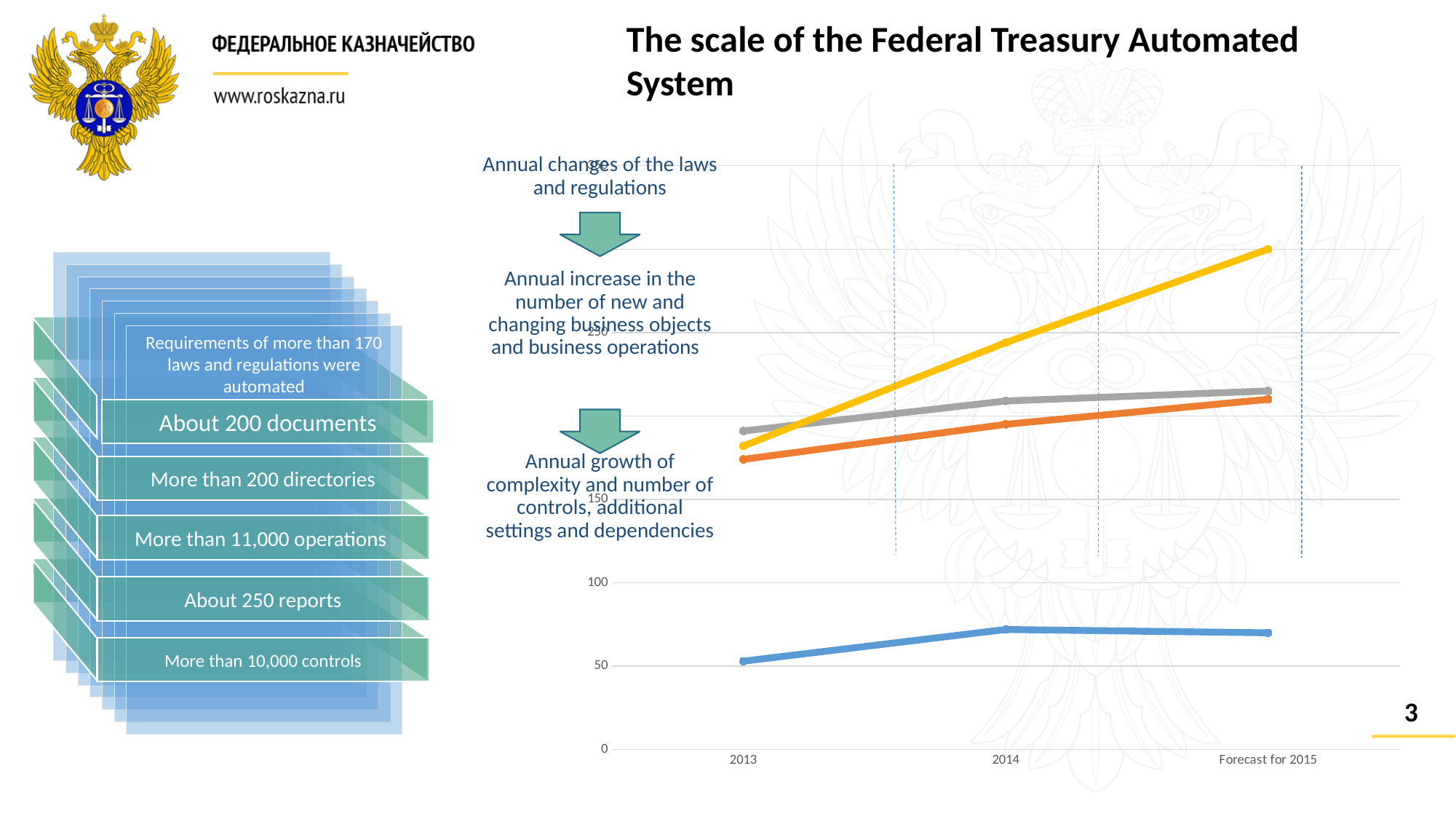
Does the yellow line rise or fall from 2013 to Forecast for 2015? rise Which line is highest at Forecast for 2015 on the line chart? the yellow line Is the value of the blue line in 2014 greater or less than 50? greater Is the value of the blue line in 2013 greater or less than 100? less Is the value of the yellow line at Forecast for 2015 greater or less than 250? greater Which line is lowest at Forecast for 2015 on the line chart? the blue line How many points are labelled on the x axis of the line chart? 3 What kind of chart is shown on the right side of the slide? line chart At Forecast for 2015, which is larger on the line chart: the yellow line or the blue line? the yellow line How many lines are plotted on the line chart? 4 What is the label of the last point on the x axis of the line chart? Forecast for 2015